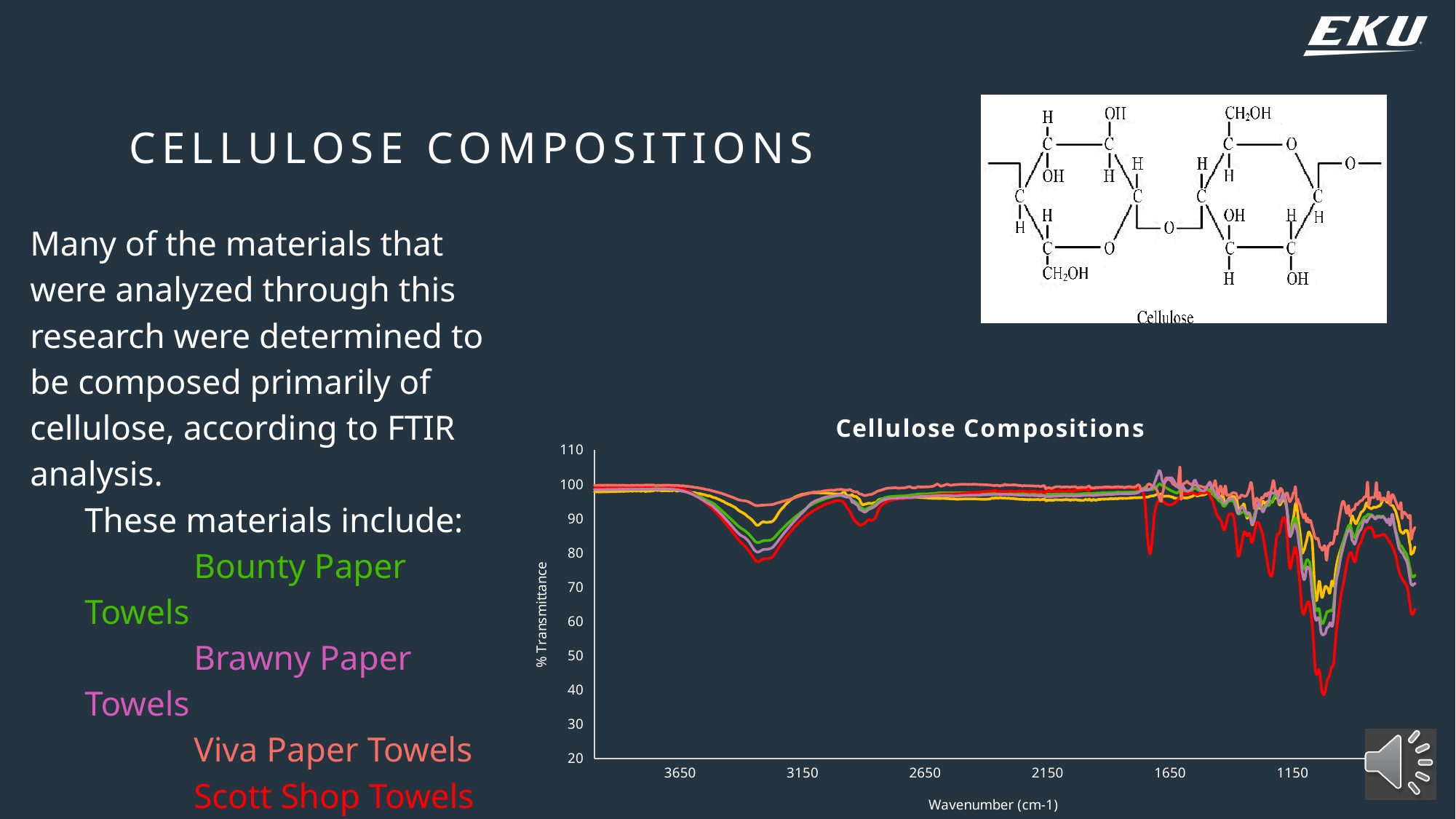
What kind of chart is the 'Cellulose Compositions' chart? line chart On the 'Cellulose Compositions' chart, is the lowest point of the red line greater or less than 30? greater What is the label of the y axis on the 'Cellulose Compositions' chart? % Transmittance On the 'Cellulose Compositions' chart, is the lowest point of the red line greater or less than 50? less How many tick labels are shown on the x axis of the 'Cellulose Compositions' chart? 6 What is the highest tick value shown on the y axis of the 'Cellulose Compositions' chart? 110 What is the title of the chart on the slide? Cellulose Compositions How many coloured lines are plotted on the 'Cellulose Compositions' chart? 5 On the 'Cellulose Compositions' chart, which coloured line reaches the lowest % Transmittance value? red What is the lowest tick value shown on the y axis of the 'Cellulose Compositions' chart? 20 On the 'Cellulose Compositions' chart, is the red line's dip near wavenumber 3300 greater or less than 90? less On the 'Cellulose Compositions' chart, near the 3150 wavenumber dip, is the red line higher or lower than the salmon (pink-orange) line? lower